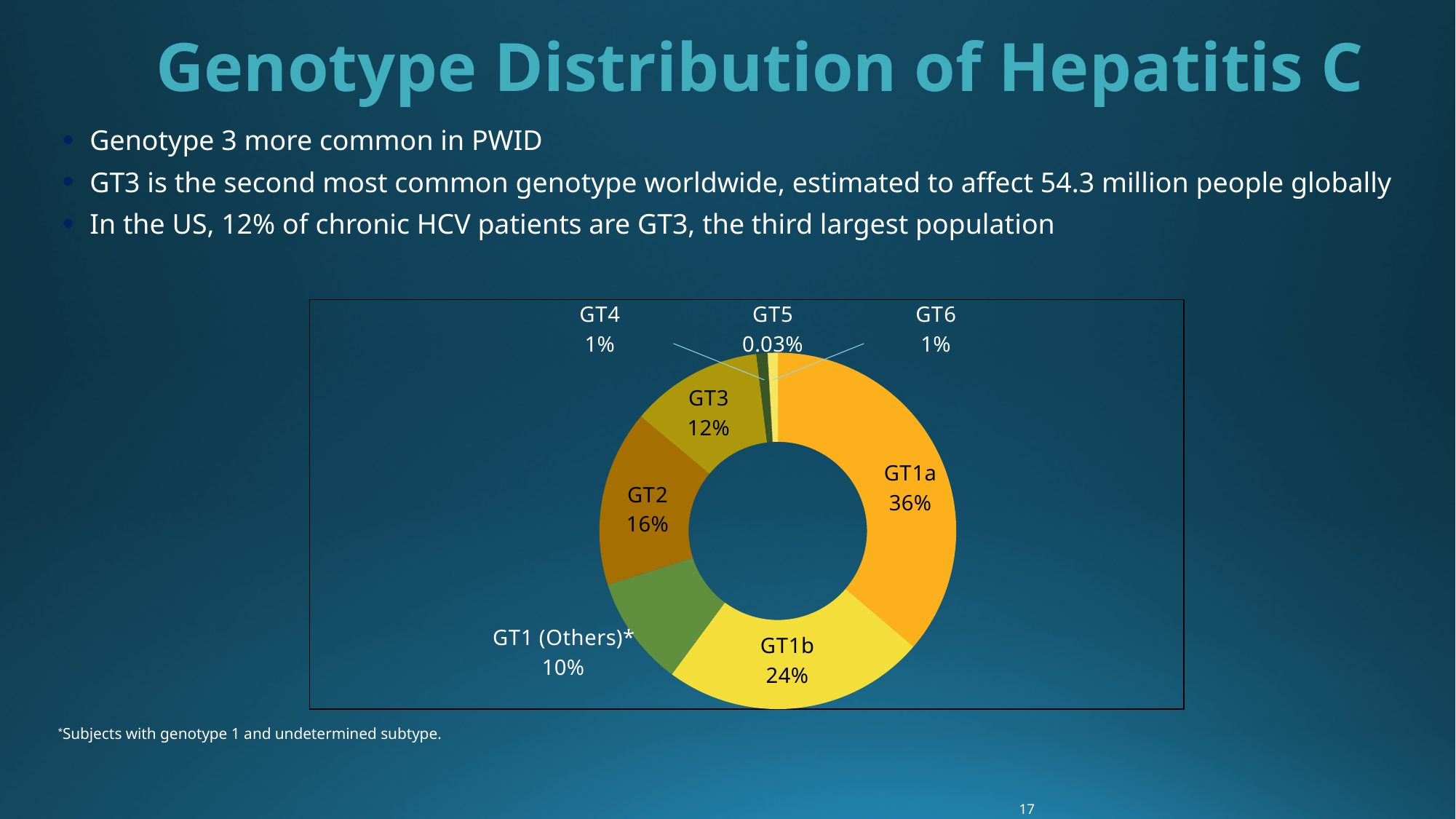
What percentage is shown for GT3? 12% Which genotype has the smallest share of the chart? GT5 Which has a larger share, GT2 or GT1 (Others)*? GT2 What kind of chart is shown on the slide? Doughnut chart What percentage is shown for GT5? 0.03% What is the combined share of GT1a and GT1b? 60% What percentage is shown for GT1 (Others)*? 10% Which genotype has the largest share of the chart? GT1a What share of the chart does GT1a represent? 36% What is the difference in percentage points between GT2 and GT3? 4 What is the difference in percentage points between GT1a and GT1b? 12 How many genotype categories are shown in the chart? 8